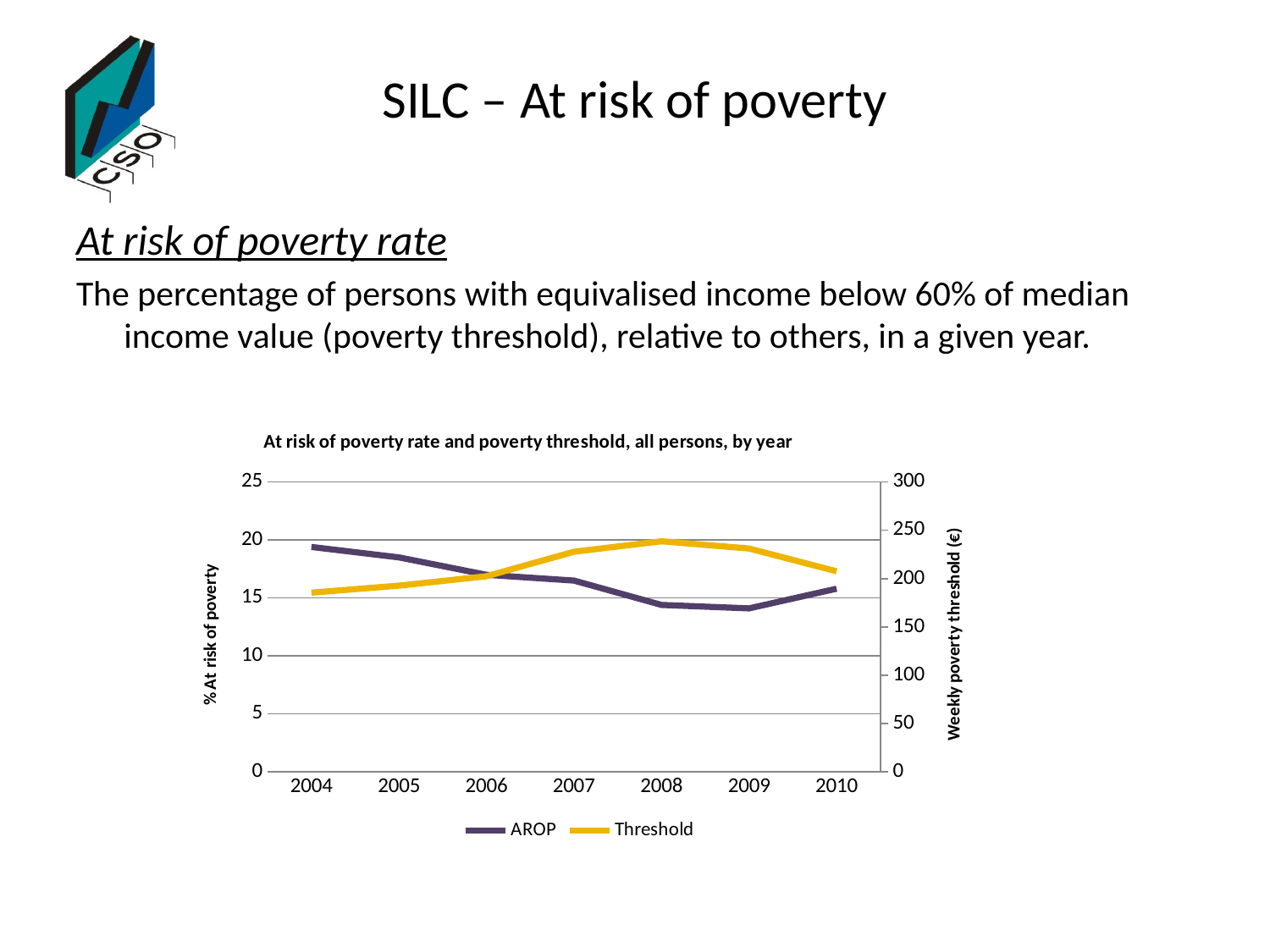
In which year is the Threshold series at its highest? 2008 What kind of chart is shown on the slide? line chart Does the AROP series rise or fall between 2004 and 2009? fall What is the label of the right-hand vertical axis of the chart? Weekly poverty threshold (€) How many years are plotted along the x axis of the chart? 7 How many series does the chart legend list? 2 Is the AROP value for 2008 greater or less than 15? less In which year is the AROP series at its highest? 2004 Is the Threshold value for 2007 greater or less than 200? greater In which year is the Threshold series at its lowest? 2004 Which is larger, the AROP value for 2004 or the AROP value for 2010? 2004 Is the AROP value for 2004 greater or less than 15? greater